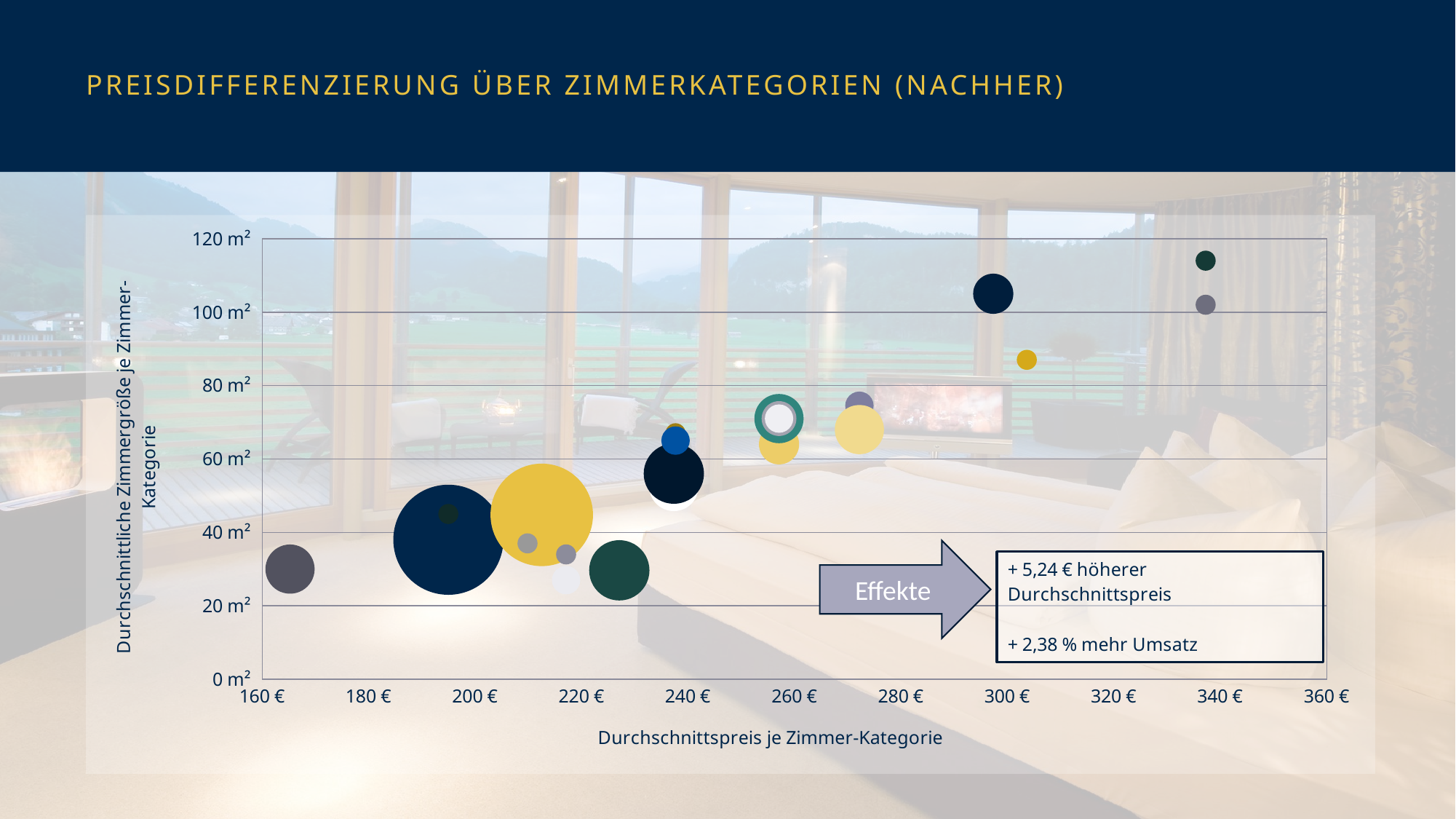
Is the average price of the largest bubble greater or less than 220 €? less Is the average price of the large yellow bubble greater or less than 200 €? greater What is the title of the chart slide? PREISDIFFERENZIERUNG ÜBER ZIMMERKATEGORIEN (NACHHER) Is the average room size of the leftmost bubble greater or less than 40 m²? less Do the average room sizes generally rise or fall as the average price increases along the x axis? rise What is the label of the x axis? Durchschnittspreis je Zimmer-Kategorie What kind of chart is shown on the slide? bubble chart